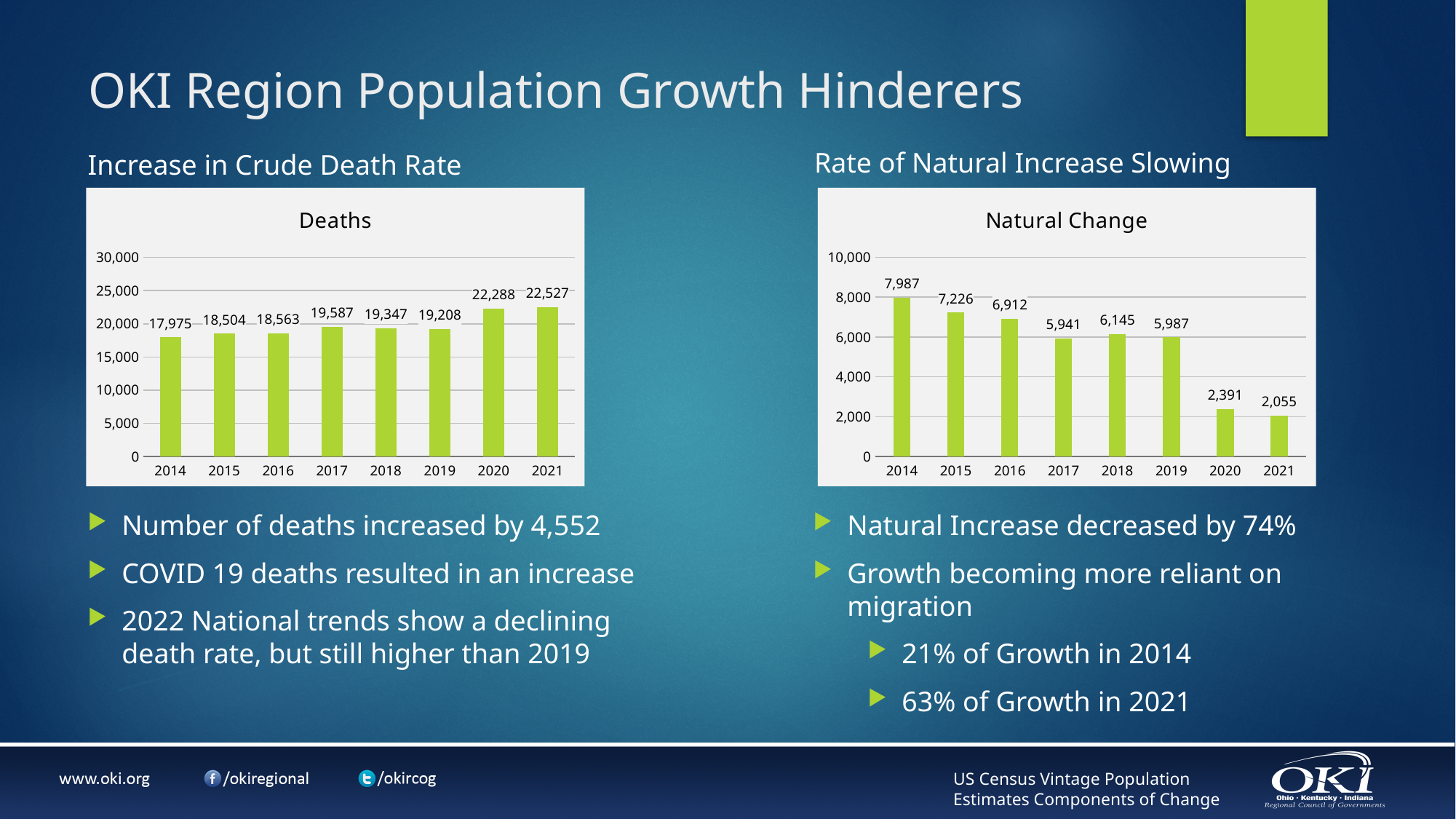
In the Natural Change chart, which year has the lowest value? 2021 In the Natural Change chart, what is the value for 2018? 6,145 In the Deaths chart, which year has the lowest value? 2014 In the Deaths chart, how many years are shown on the x axis? 8 In the Deaths chart, is the value for 2020 greater or less than 20,000? greater In the Deaths chart, which year has the highest value? 2021 In the Deaths chart, what is the value for 2014? 17,975 In the Natural Change chart, which is larger, the value for 2017 or the value for 2019? 2019 In the Natural Change chart, which year has the highest value? 2014 In the Deaths chart, what is the difference between the 2021 and 2014 values? 4,552 In the Natural Change chart, what is the difference between the 2014 and 2021 values? 5,932 What kind of chart is the Natural Change chart? Bar chart